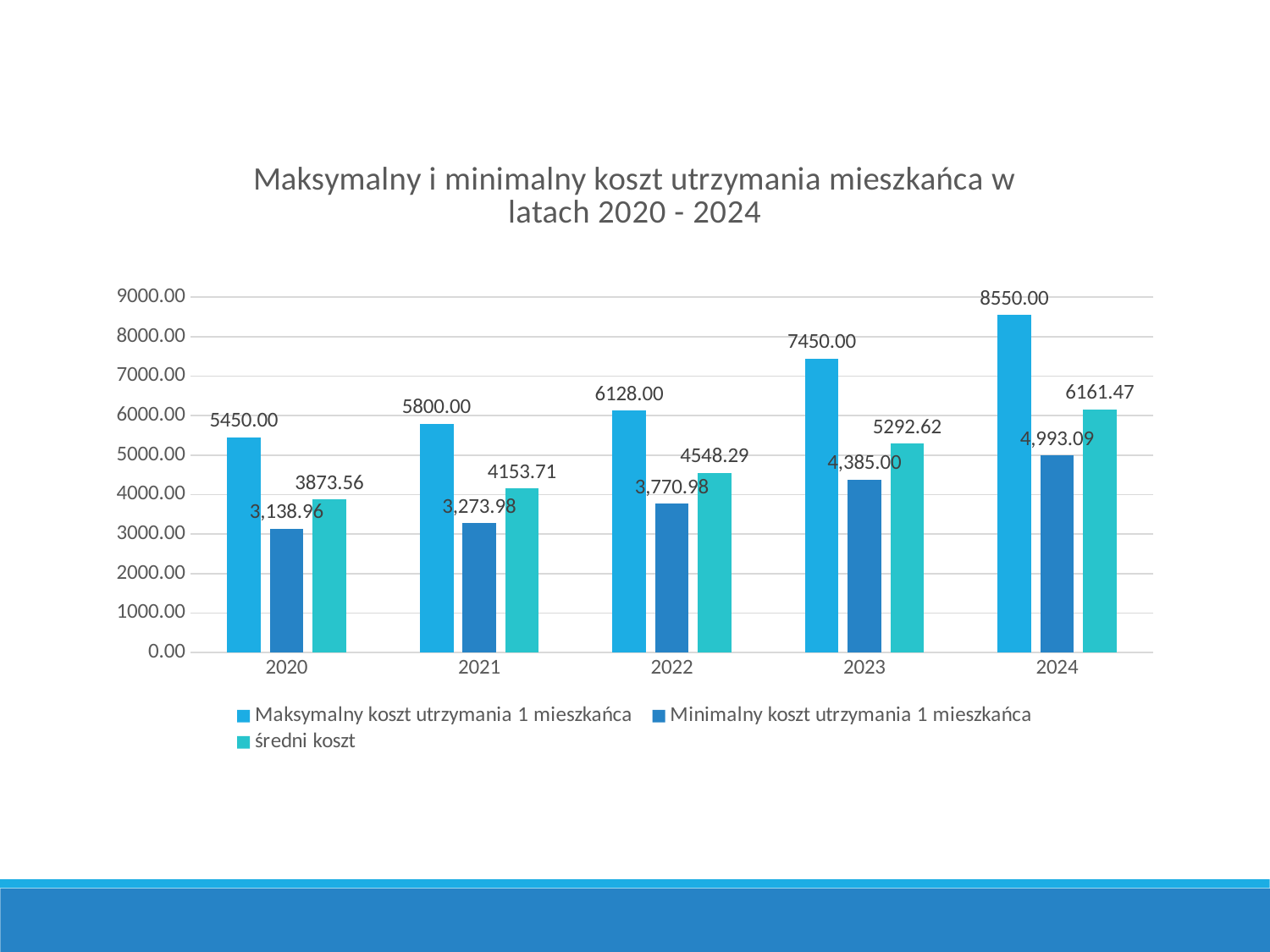
What is the difference between 'Maksymalny koszt utrzymania 1 mieszkańca' in 2023 and in 2020? 2000.00 What is the value of 'Minimalny koszt utrzymania 1 mieszkańca' for 2021? 3,273.98 What kind of chart is shown on the slide? bar chart How many series does the legend list? 3 In which year is 'Minimalny koszt utrzymania 1 mieszkańca' the lowest? 2020 Does 'średni koszt' rise or fall from 2020 to 2024? rise In which year is 'Maksymalny koszt utrzymania 1 mieszkańca' the highest? 2024 How many years are shown on the x axis? 5 What is the value of 'Maksymalny koszt utrzymania 1 mieszkańca' for 2024? 8550.00 Which is larger: 'średni koszt' in 2024 or 'Maksymalny koszt utrzymania 1 mieszkańca' in 2022? średni koszt in 2024 Is the value of 'Minimalny koszt utrzymania 1 mieszkańca' for 2023 greater or less than 4000.00? greater What is the value of 'średni koszt' for 2022? 4548.29